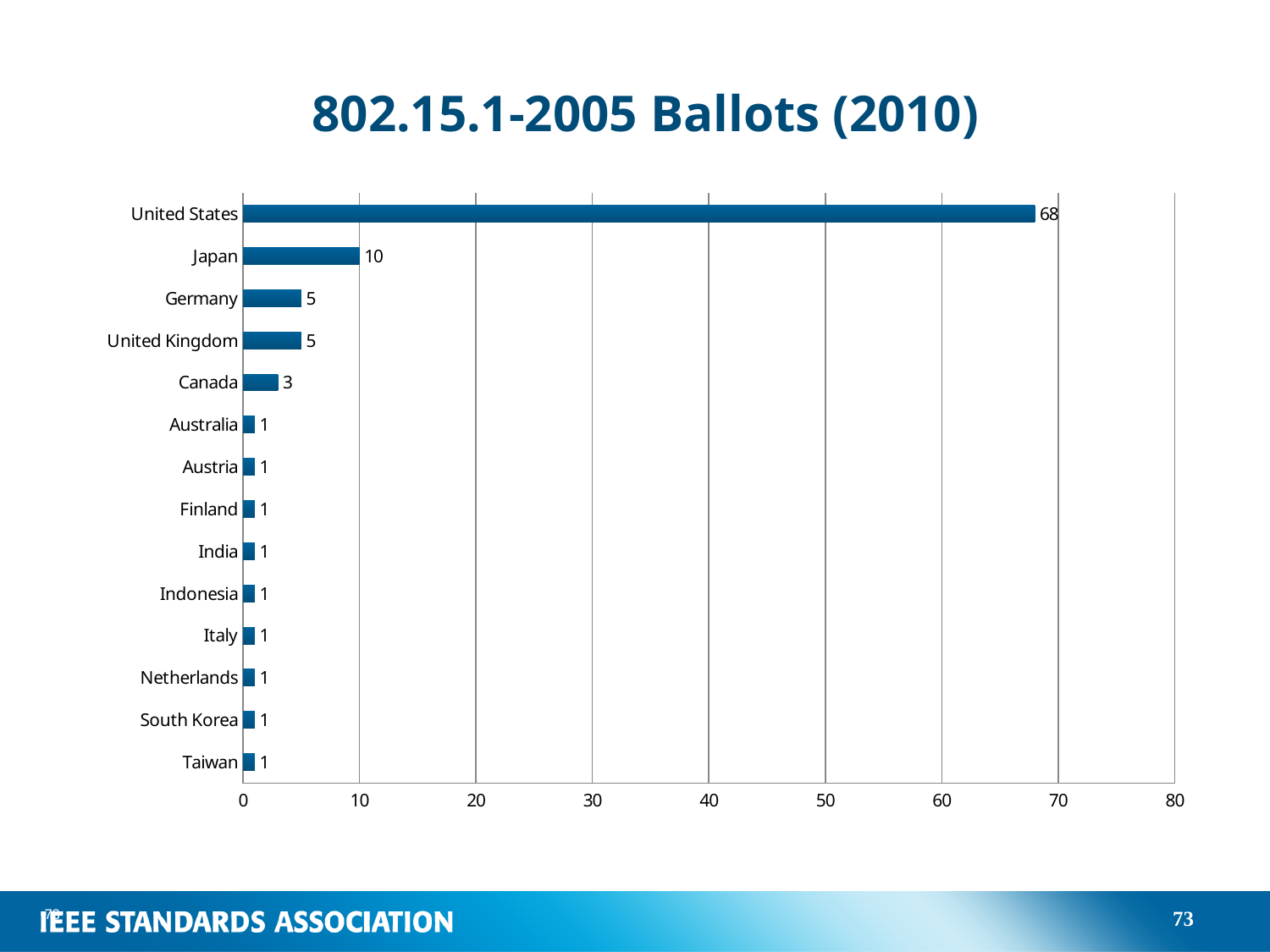
Which country has the highest value? United States What is the title of the chart? 802.15.1-2005 Ballots (2010) What is the value for Canada? 3 How many countries are shown on the chart? 14 What kind of chart is shown on the slide? Bar chart Which is larger, the value for Germany or the value for Canada? Germany What is the difference between the values for the United States and Japan? 58 What is the value for Japan? 10 Is the value for the United States greater or less than 60? greater How many countries have a value of 1? 9 What is the value for the United States? 68 What is the difference between the values for Japan and Germany? 5